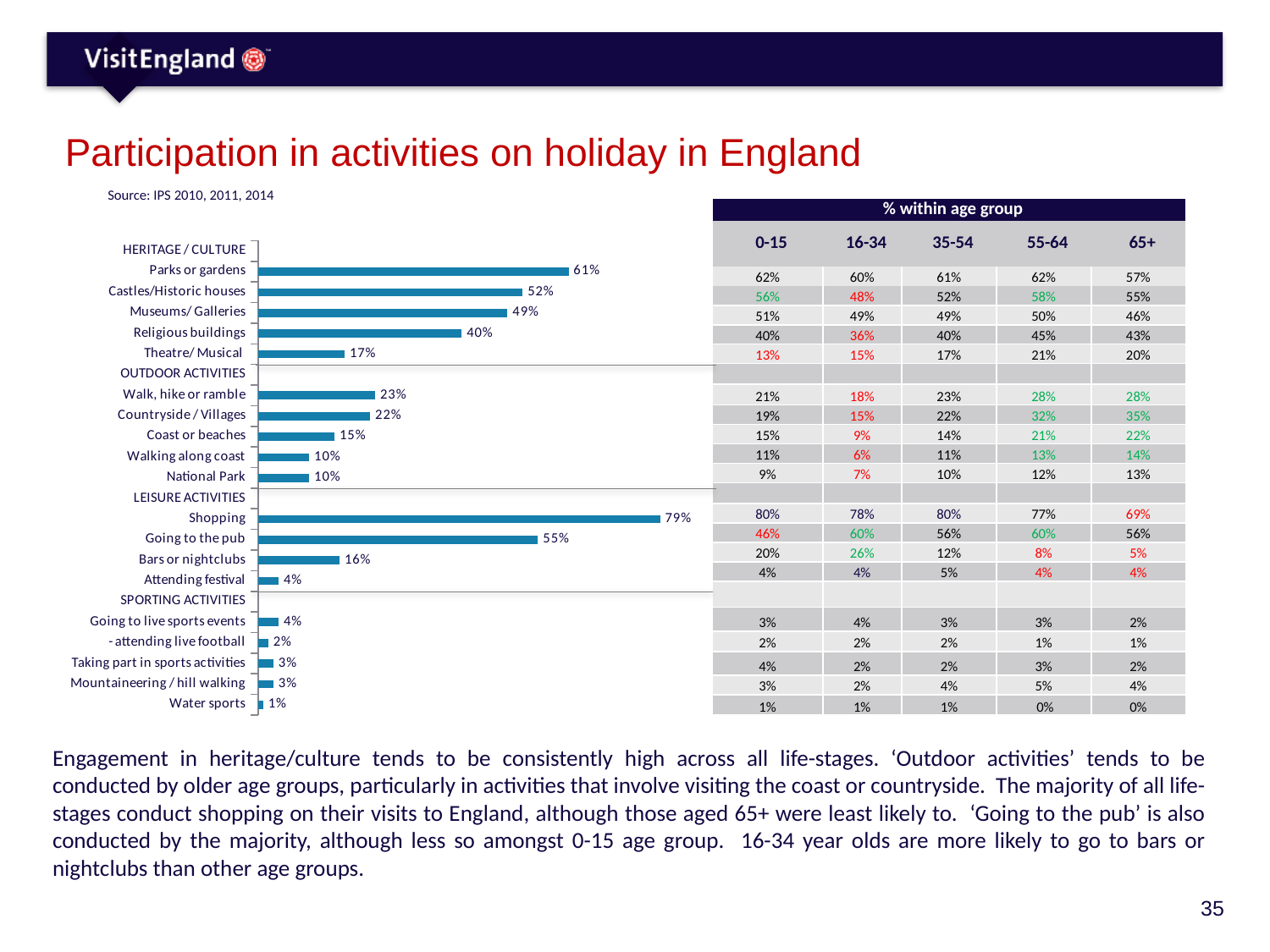
Which activity has the highest participation percentage in the bar chart? Shopping Which has a higher participation percentage in the bar chart, Countryside/Villages or Coast or beaches? Countryside/Villages What is the difference in participation between Castles/Historic houses and Museums/Galleries in the bar chart? 3% What is the difference in participation between Shopping and Going to the pub in the bar chart? 24% What is the participation percentage for Parks or gardens in the bar chart? 61% What type of chart is used to show participation in activities on holiday in England? Bar chart How many activities have bars plotted in the bar chart? 19 Which has a higher participation percentage in the bar chart, Theatre/Musical or Bars or nightclubs? Theatre/Musical What is the participation percentage for Religious buildings in the bar chart? 40% What is the participation percentage for Going to the pub in the bar chart? 55% What is the participation percentage for Walk, hike or ramble in the bar chart? 23% Which activity has the lowest participation percentage in the bar chart? Water sports